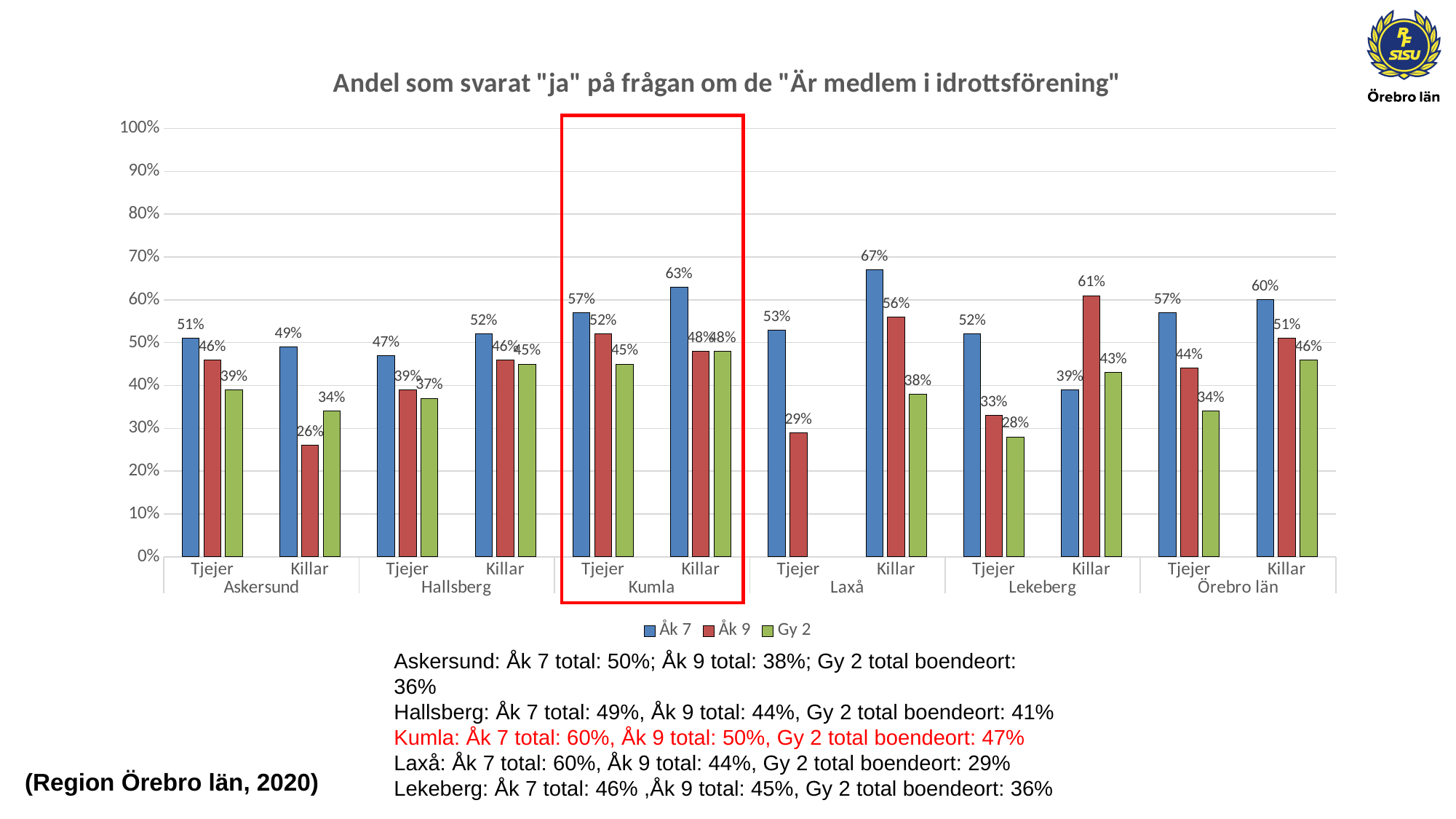
How many series does the legend list? 3 What is the difference between the Åk 7 value for Killar in Laxå and the Åk 7 value for Tjejer in Laxå? 14% How many Tjejer/Killar groups are shown on the x axis? 12 What is the Gy 2 value for Tjejer in Lekeberg? 28% Which colour represents the Gy 2 series in the legend? green Which is larger for Killar in Lekeberg: the Åk 7 value or the Åk 9 value? Åk 9 Is the Åk 9 value for Tjejer in Laxå greater or less than 30%? less What type of chart is shown on the slide? bar chart What is the Åk 9 value for Killar in Askersund? 26% Which group has the highest Åk 7 value? Killar in Laxå Which group has the lowest Åk 9 value? Killar in Askersund What is the Åk 7 value for Killar in Kumla? 63%